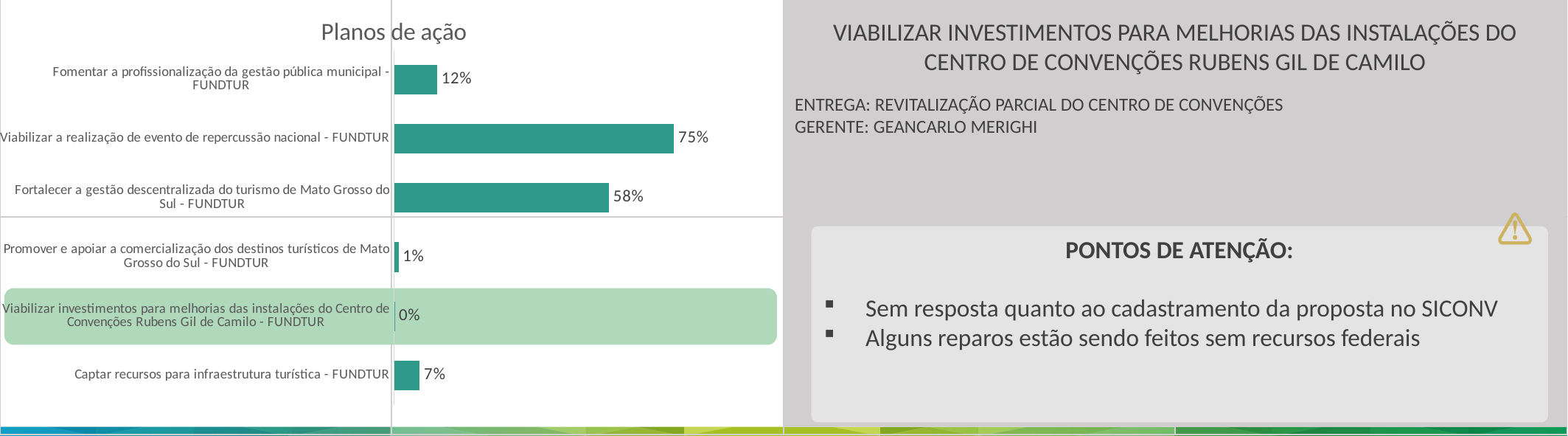
What is the value for "Viabilizar investimentos para melhorias das instalações do Centro de Convenções Rubens Gil de Camilo - FUNDTUR"? 0% Which category has the lowest value? Viabilizar investimentos para melhorias das instalações do Centro de Convenções Rubens Gil de Camilo - FUNDTUR How many categories does the chart show? 6 What is the difference between the values for "Viabilizar a realização de evento de repercussão nacional - FUNDTUR" and "Fortalecer a gestão descentralizada do turismo de Mato Grosso do Sul - FUNDTUR"? 17% What is the value for "Fortalecer a gestão descentralizada do turismo de Mato Grosso do Sul - FUNDTUR"? 58% What is the title of the chart? Planos de ação Which is larger: the value for "Fomentar a profissionalização da gestão pública municipal - FUNDTUR" or for "Captar recursos para infraestrutura turística - FUNDTUR"? Fomentar a profissionalização da gestão pública municipal - FUNDTUR What is the difference between the values for "Fomentar a profissionalização da gestão pública municipal - FUNDTUR" and "Promover e apoiar a comercialização dos destinos turísticos de Mato Grosso do Sul - FUNDTUR"? 11% What is the value for "Viabilizar a realização de evento de repercussão nacional - FUNDTUR"? 75% Which category has the highest value? Viabilizar a realização de evento de repercussão nacional - FUNDTUR What is the value for "Captar recursos para infraestrutura turística - FUNDTUR"? 7% What kind of chart is shown on the slide? bar chart